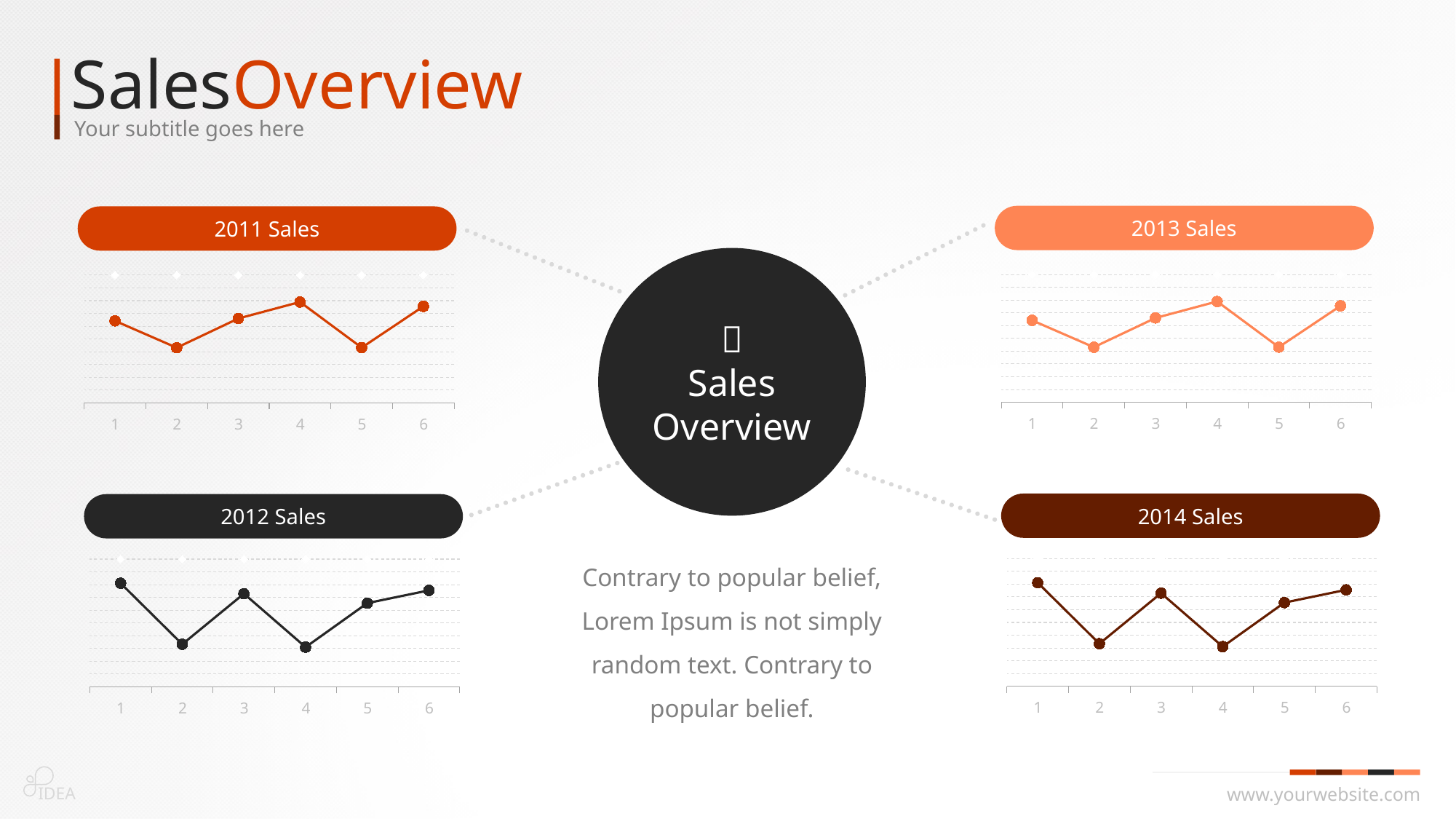
In the 2011 Sales chart, do the values rise or fall from point 2 to point 4? rise What kind of chart is the 2011 Sales chart? line chart In the 2014 Sales chart, do the values rise or fall from point 1 to point 2? fall What colour is the line in the 2012 Sales chart? black In the 2013 Sales chart, is the value at point 3 larger or smaller than the value at point 2? larger How many data points are plotted on the 2012 Sales chart? 6 In the 2012 Sales chart, is the value at point 1 larger or smaller than the value at point 2? larger How many charts are shown on the slide? 4 In the 2014 Sales chart, is the value at point 4 larger or smaller than the value at point 5? smaller What is the title of the chart in the bottom-right of the slide? 2014 Sales In the 2011 Sales chart, which x-axis point has the highest value? 4